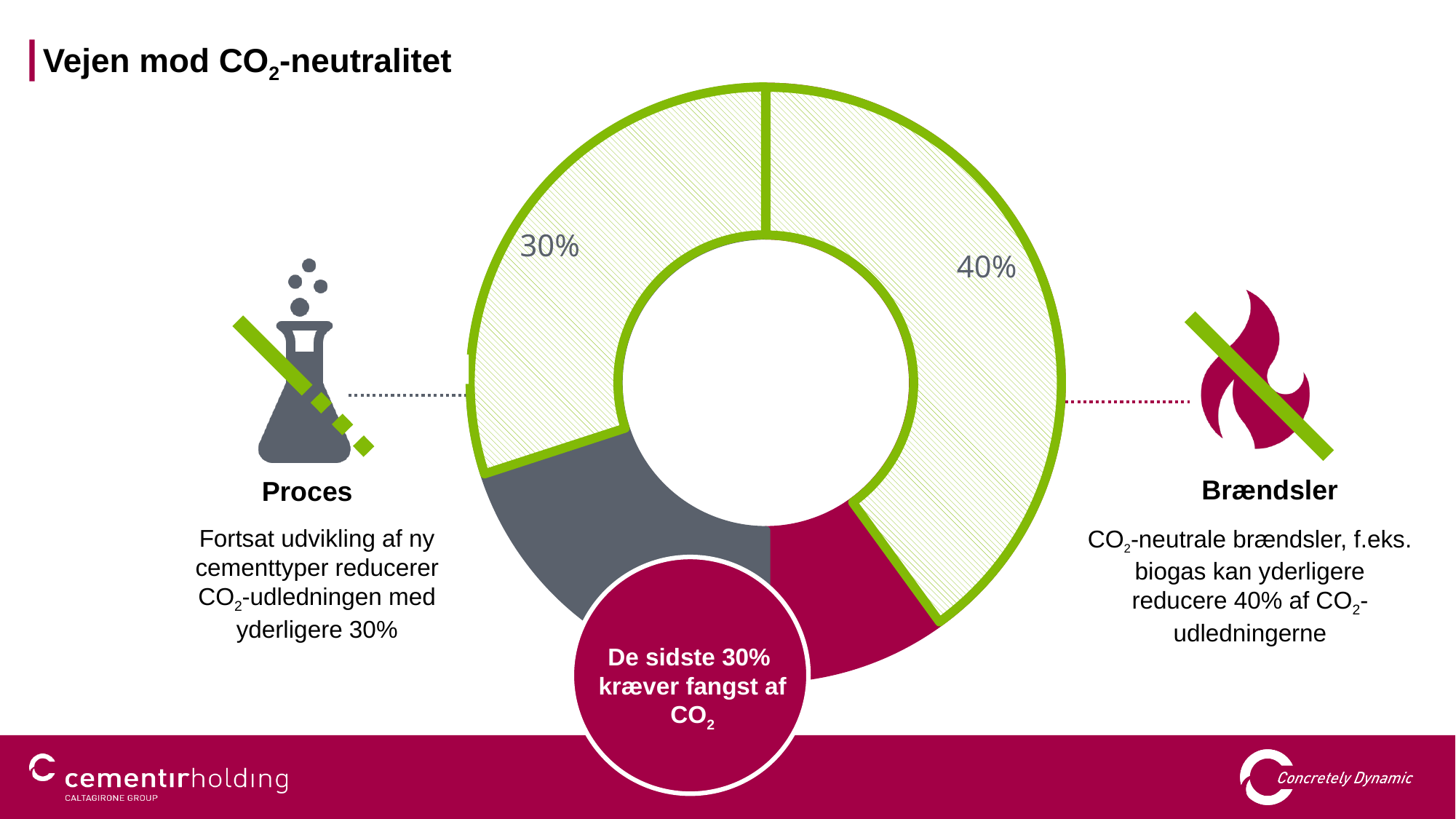
Which is larger, the Proces slice or the Brændsler slice? Brændsler What is the difference in percentage points between the Brændsler slice (40%) and the Proces slice (30%)? 10 percentage points According to the slide, what share of CO2 emissions requires CO2 capture? 30% What kind of chart is shown on the slide? Pie (donut) chart What percentage is shown for the Proces slice of the donut chart? 30% Which labelled slice of the donut chart is the largest? Brændsler (40%) What share of the donut chart do the Proces and Brændsler slices account for together? 70% What is the title of the slide? Vejen mod CO2-neutralitet Which two categories are labelled with icons on either side of the donut chart? Proces and Brændsler What percentage is shown for the Brændsler slice of the donut chart? 40%